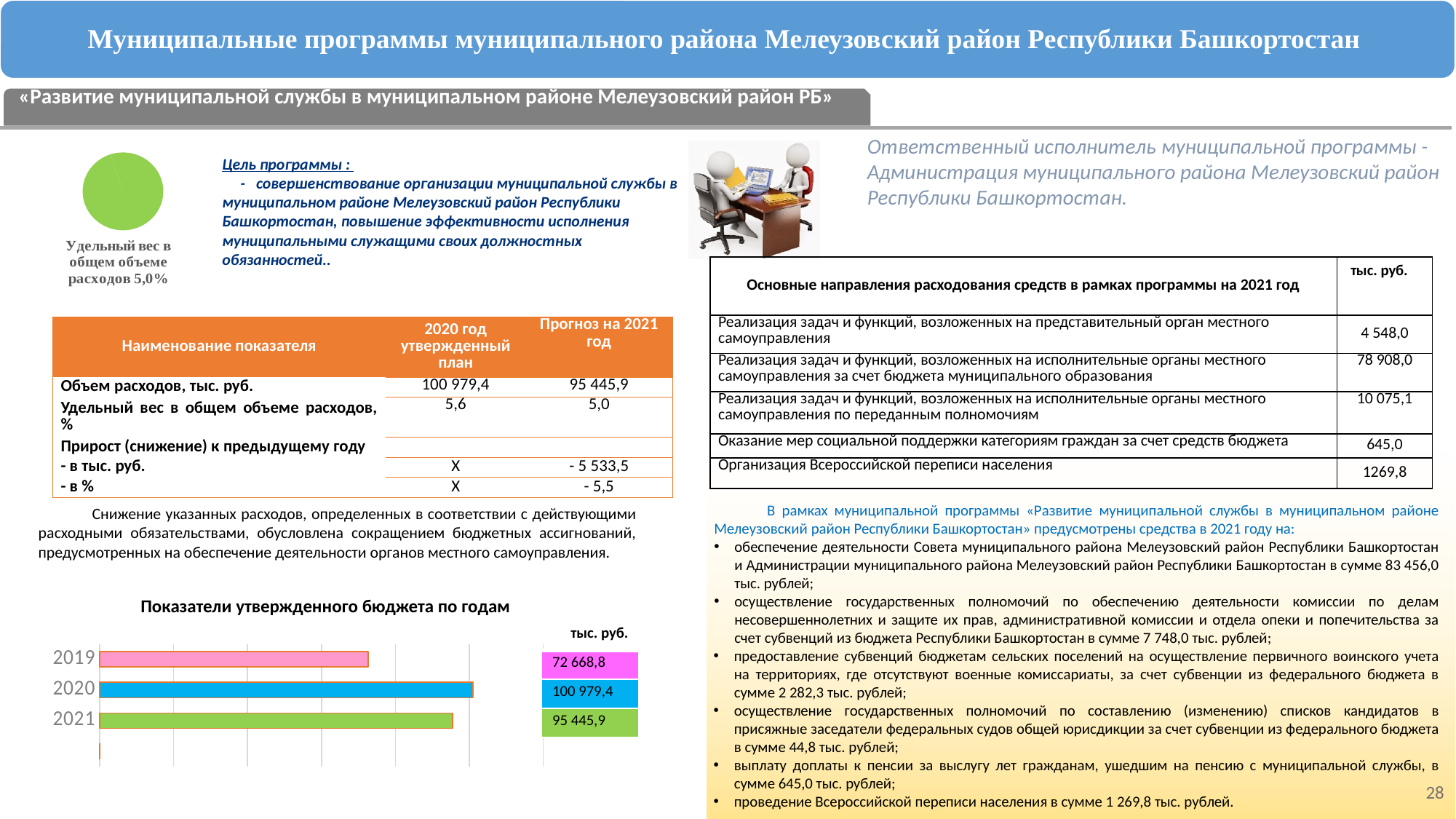
In the chart 'Показатели утвержденного бюджета по годам', what is the value for 2021? 95 445,9 In the chart 'Показатели утвержденного бюджета по годам', which year has the lowest value? 2019 In the chart 'Показатели утвержденного бюджета по годам', what is the difference between the values for 2020 and 2019? 28 310,6 What kind of chart is 'Показатели утвержденного бюджета по годам'? bar chart In the chart 'Показатели утвержденного бюджета по годам', what is the difference between the values for 2020 and 2021? 5 533,5 In the chart 'Показатели утвержденного бюджета по годам', which year has the highest value? 2020 In the chart 'Показатели утвержденного бюджета по годам', what unit is stated for the values? тыс. руб. In the chart 'Показатели утвержденного бюджета по годам', what is the value for 2019? 72 668,8 According to the pie chart at the top left of the slide, what share of total expenditure does the programme account for? 5,0% How many years are shown in the chart 'Показатели утвержденного бюджета по годам'? 3 In the chart 'Показатели утвержденного бюджета по годам', what is the value for 2020? 100 979,4 In the chart 'Показатели утвержденного бюджета по годам', which is larger, the value for 2019 or the value for 2021? 2021